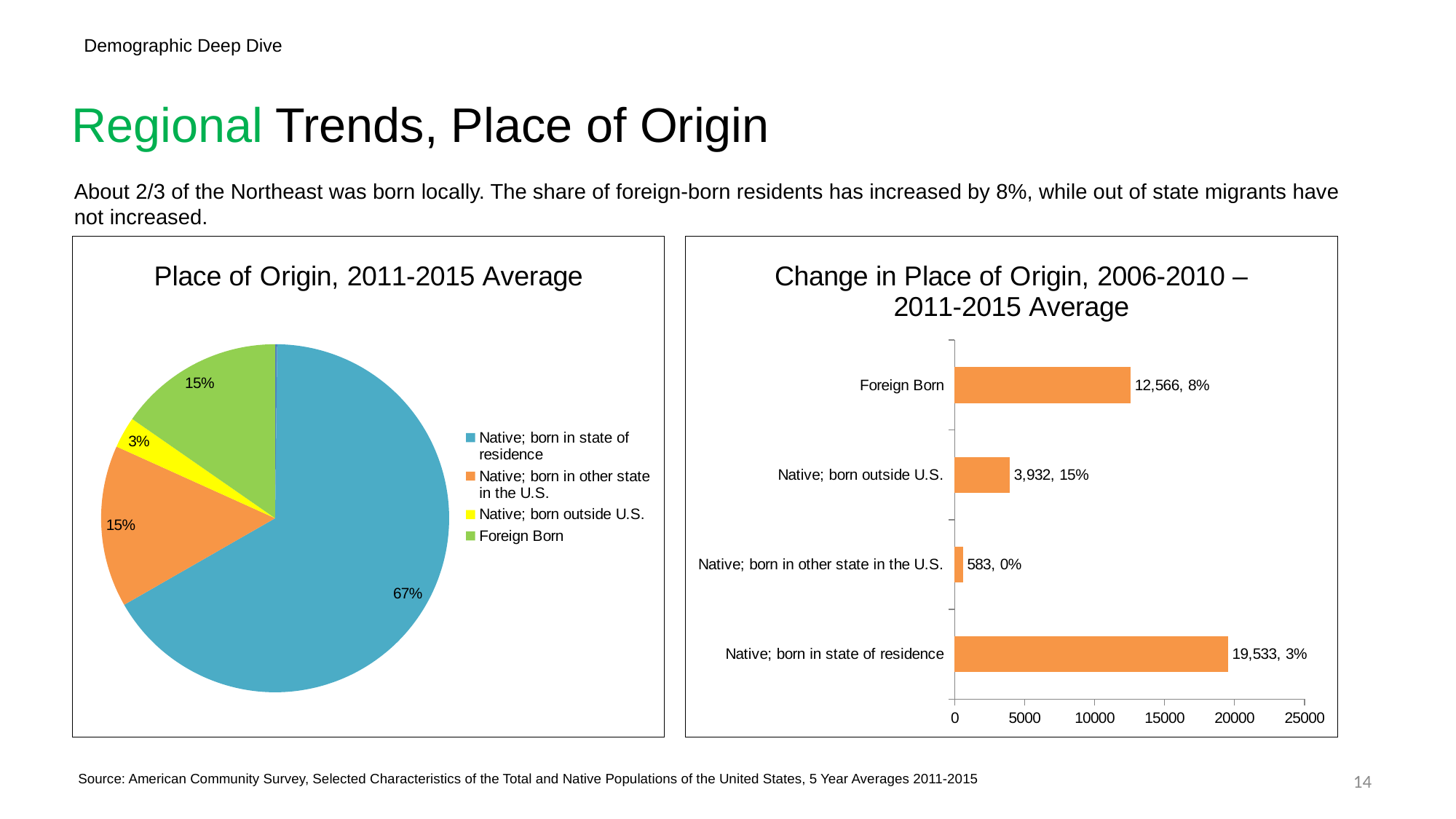
In the chart 'Change in Place of Origin, 2006-2010 – 2011-2015 Average', what is the difference between the values for Native; born in state of residence (19,533) and Foreign Born (12,566)? 6,967 In the pie chart 'Place of Origin, 2011-2015 Average', what colour is the Foreign Born slice? Green In the chart 'Change in Place of Origin, 2006-2010 – 2011-2015 Average', what is the data label for Native; born in other state in the U.S.? 583, 0% In the pie chart 'Place of Origin, 2011-2015 Average', what share is labelled for Native; born outside U.S.? 3% In the pie chart 'Place of Origin, 2011-2015 Average', what share is labelled for Native; born in state of residence? 67% In the pie chart 'Place of Origin, 2011-2015 Average', which category has the smallest slice? Native; born outside U.S. In the chart 'Change in Place of Origin, 2006-2010 – 2011-2015 Average', which category has the longest bar? Native; born in state of residence In the chart 'Change in Place of Origin, 2006-2010 – 2011-2015 Average', which category has the shortest bar? Native; born in other state in the U.S. How many categories does the legend of the pie chart 'Place of Origin, 2011-2015 Average' list? 4 In the pie chart 'Place of Origin, 2011-2015 Average', which category has the largest slice? Native; born in state of residence In the chart 'Change in Place of Origin, 2006-2010 – 2011-2015 Average', what is the data label for Foreign Born? 12,566, 8% What kind of chart is 'Change in Place of Origin, 2006-2010 – 2011-2015 Average'? Bar chart